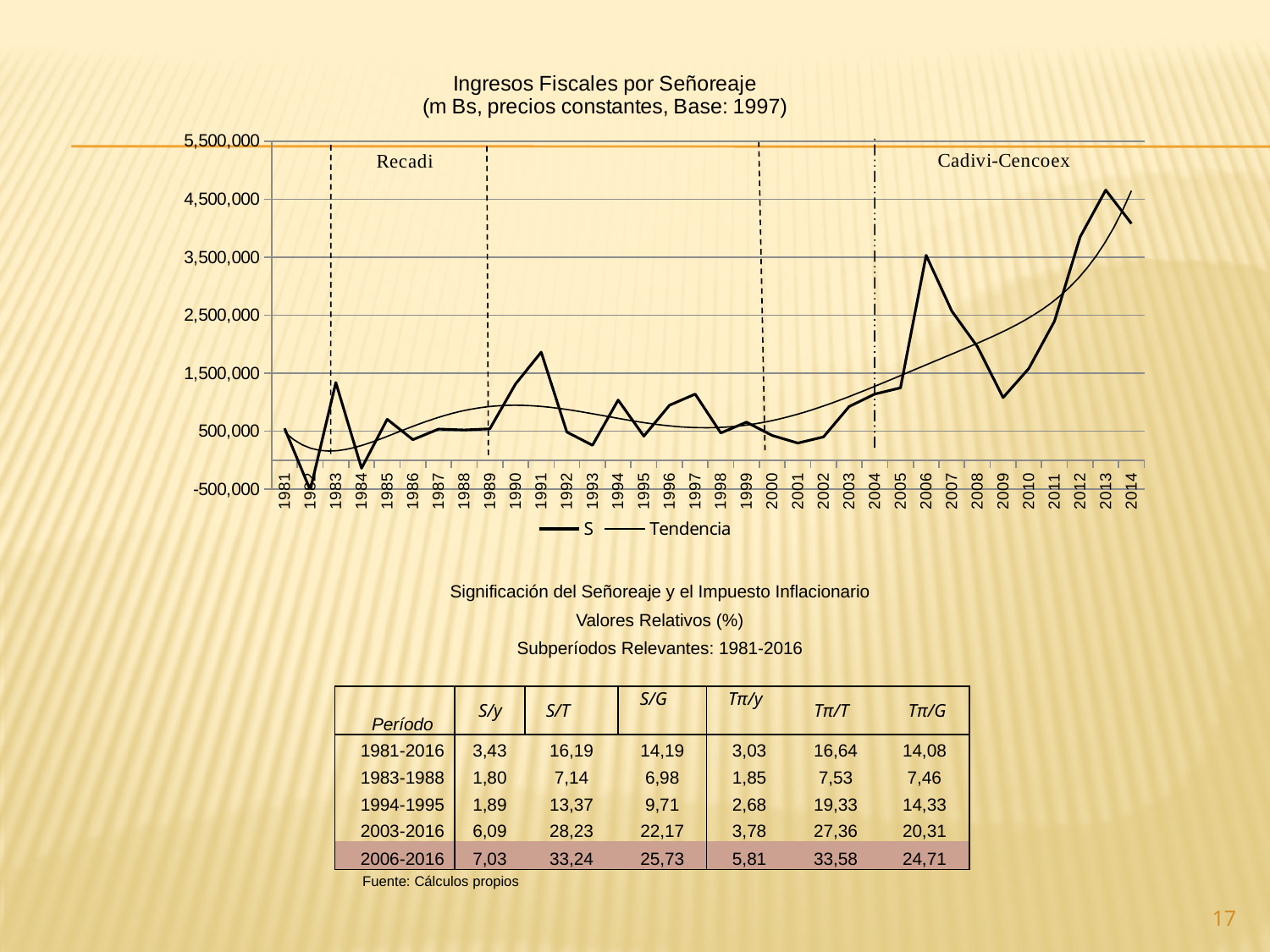
Is the value of S for 2001 greater or less than 500,000? less How many years are plotted along the x axis of the chart? 34 How many series does the chart legend list? 2 Is the value of S for 2009 greater or less than 1,500,000? less In which year does the S series reach its highest value? 2013 Does the S series rise or fall between 2009 and 2013? Rise What label appears in the upper right region of the chart, near the Cadivi period? Cadivi-Cencoex What are the two series named in the chart legend? S and Tendencia In which year does the S series reach its lowest value? 1982 What kind of chart is shown on the slide? Line chart Which year has the larger value of S, 1991 or 1994? 1991 Is the value of S for 2006 greater or less than 2,500,000? greater